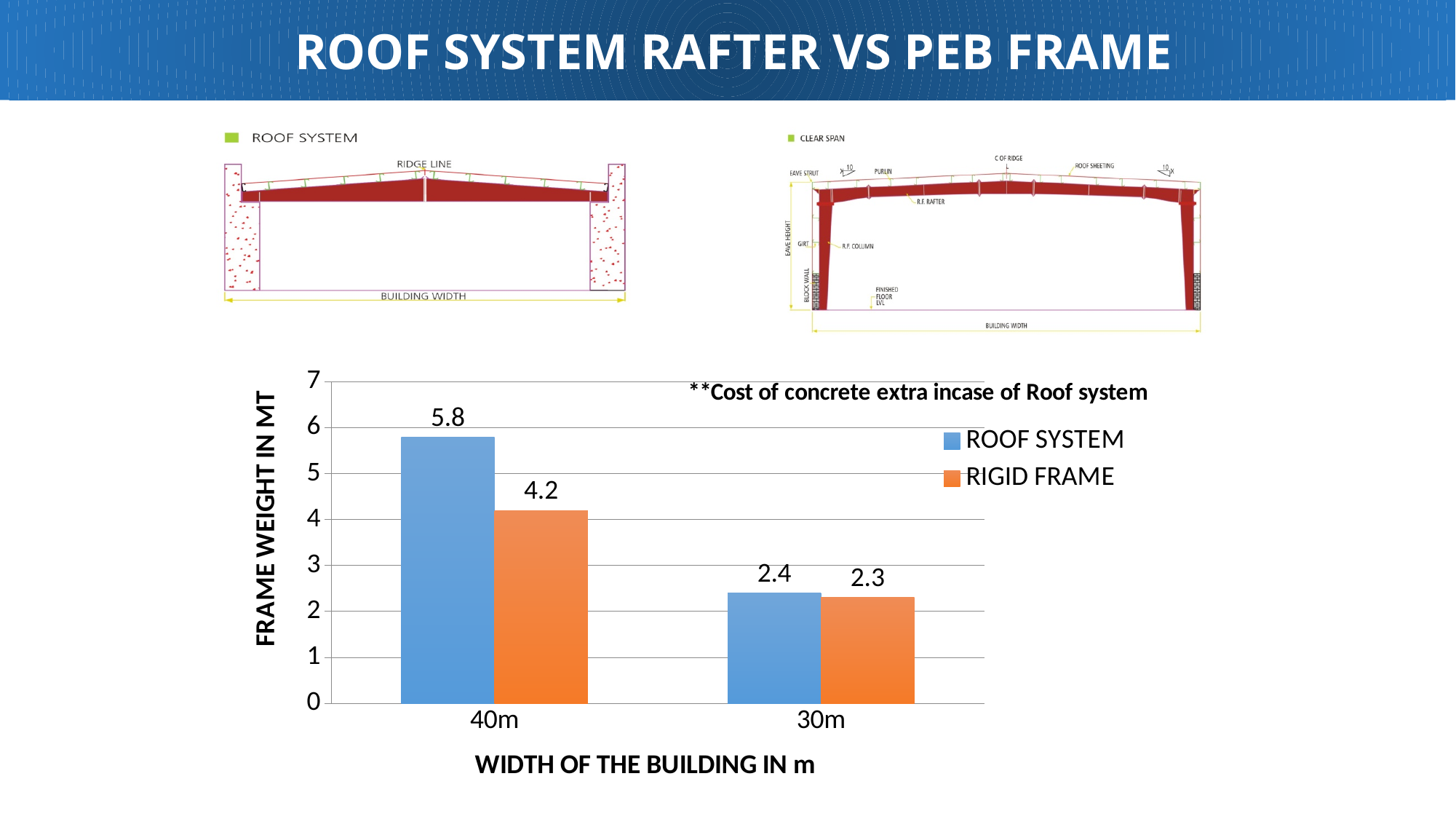
How many series does the legend list? 2 What is the frame weight for ROOF SYSTEM at a building width of 30m? 2.4 What is the frame weight for ROOF SYSTEM at a building width of 40m? 5.8 What is the frame weight for RIGID FRAME at a building width of 40m? 4.2 What kind of chart is shown on the slide? Bar chart How many building width categories are shown on the x axis? 2 Which is larger: the ROOF SYSTEM value at 40m or the RIGID FRAME value at 40m? ROOF SYSTEM at 40m What is the frame weight for RIGID FRAME at a building width of 30m? 2.3 What is the difference in frame weight for ROOF SYSTEM between 40m and 30m? 3.4 What is the label of the y axis of the chart? FRAME WEIGHT IN MT What is the difference in frame weight between ROOF SYSTEM and RIGID FRAME at 40m? 1.6 Which series has the highest frame weight at 40m? ROOF SYSTEM